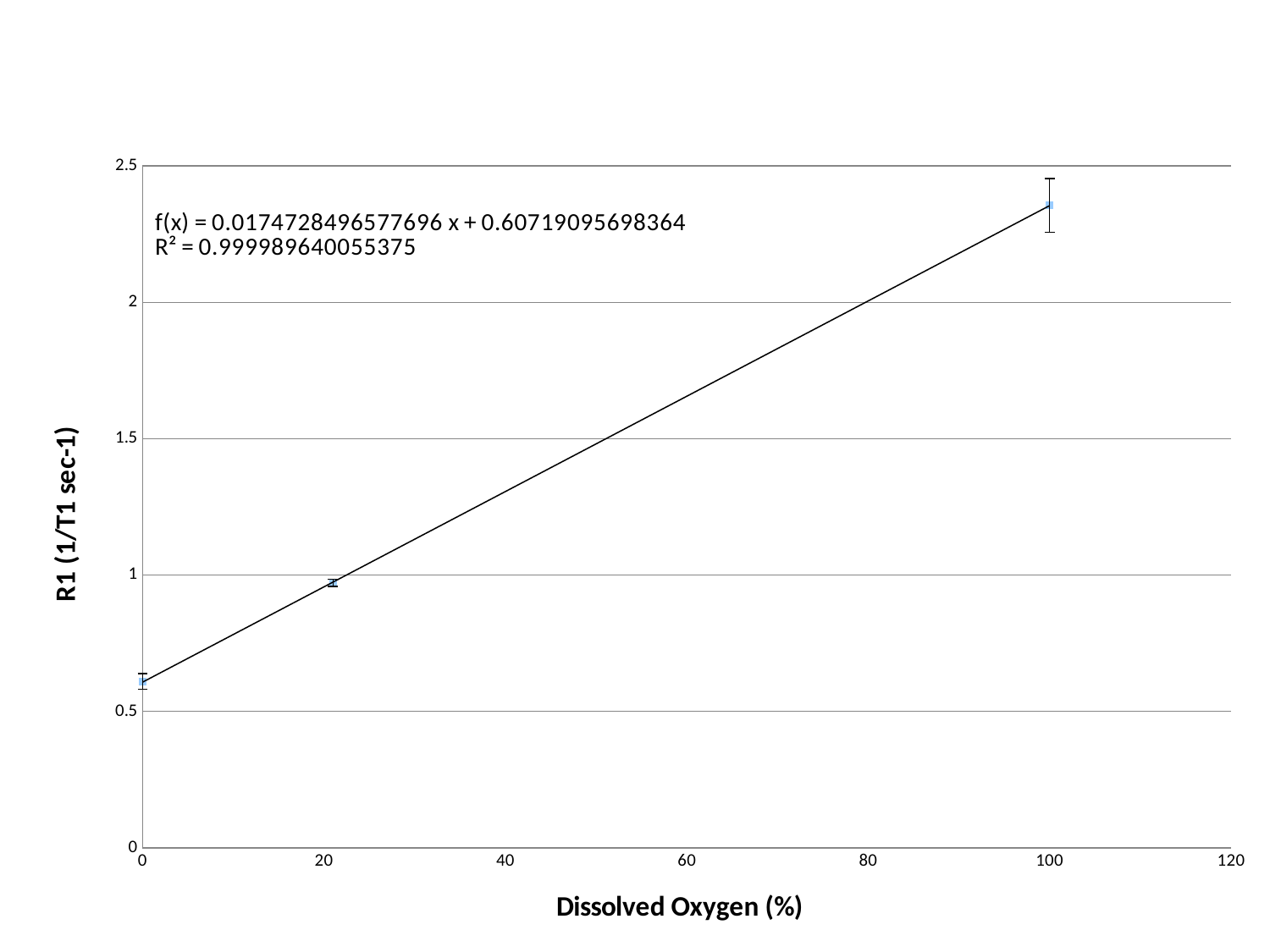
Is the R1 value at 0% Dissolved Oxygen greater or less than 0.5? greater Which has the larger R1 value: the point at 0% Dissolved Oxygen or the point at 100% Dissolved Oxygen? 100% What kind of chart is shown on the slide? scatter chart Is the R1 value at 100% Dissolved Oxygen greater or less than 2.5? less At which Dissolved Oxygen level is the R1 value lowest? 0 What is the title of the x axis? Dissolved Oxygen (%) At which Dissolved Oxygen level is the R1 value highest? 100 Is the R1 value at 0% Dissolved Oxygen greater or less than 1? less Do the R1 values rise or fall as Dissolved Oxygen increases along the x axis? rise What is the R² value shown on the chart? 0.999989640055375 How many data points are plotted on the chart? 3